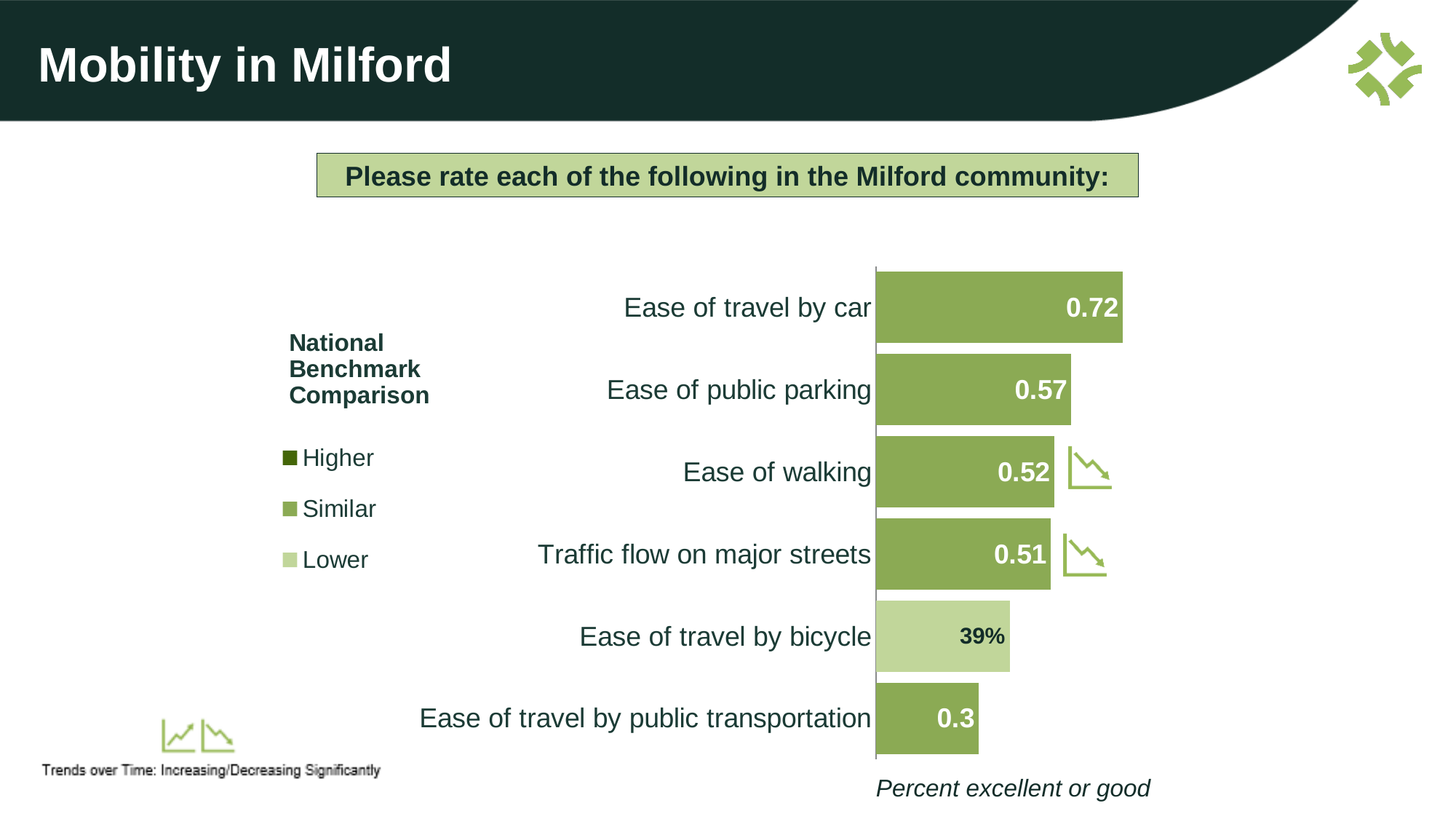
How many entries does the National Benchmark Comparison legend list? 3 What value is shown for Ease of travel by bicycle? 39% What value is shown for Ease of travel by public transportation? 0.3 Which category has the highest value? Ease of travel by car Which category has the lowest value? Ease of travel by public transportation What is the difference between the values for Ease of travel by car and Ease of public parking? 0.15 How many categories are shown in the chart? 6 What is the difference between the values for Ease of public parking and Ease of travel by public transportation? 0.27 What value is shown for Ease of travel by car? 0.72 What kind of chart is shown on the slide? Bar chart Which is larger, the value for Ease of walking or the value for Ease of travel by public transportation? Ease of walking What value is shown for Ease of public parking? 0.57